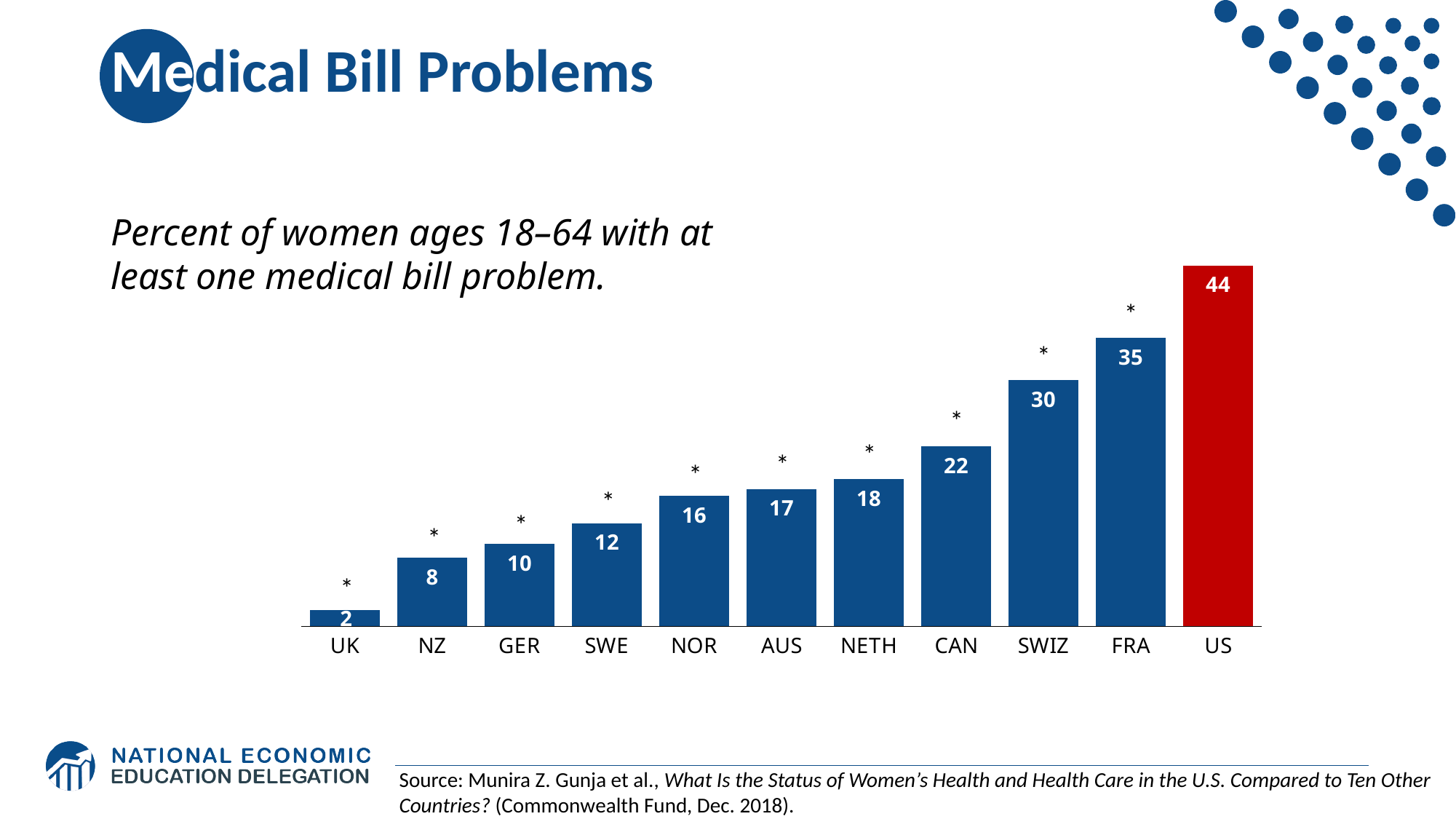
How many countries are shown on the chart? 11 What kind of chart is this? Bar chart What is the value for CAN? 22 What is the value for SWE? 12 What is the difference between the values for the US and FRA? 9 What is the difference between the values for SWIZ and NZ? 22 Which country has the highest value? US Which has a larger value, NOR or NETH? NETH Which bar is coloured red rather than blue? US Do the values rise or fall from left to right along the x axis? Rise What is the value for the US? 44 Which country has the lowest value? UK